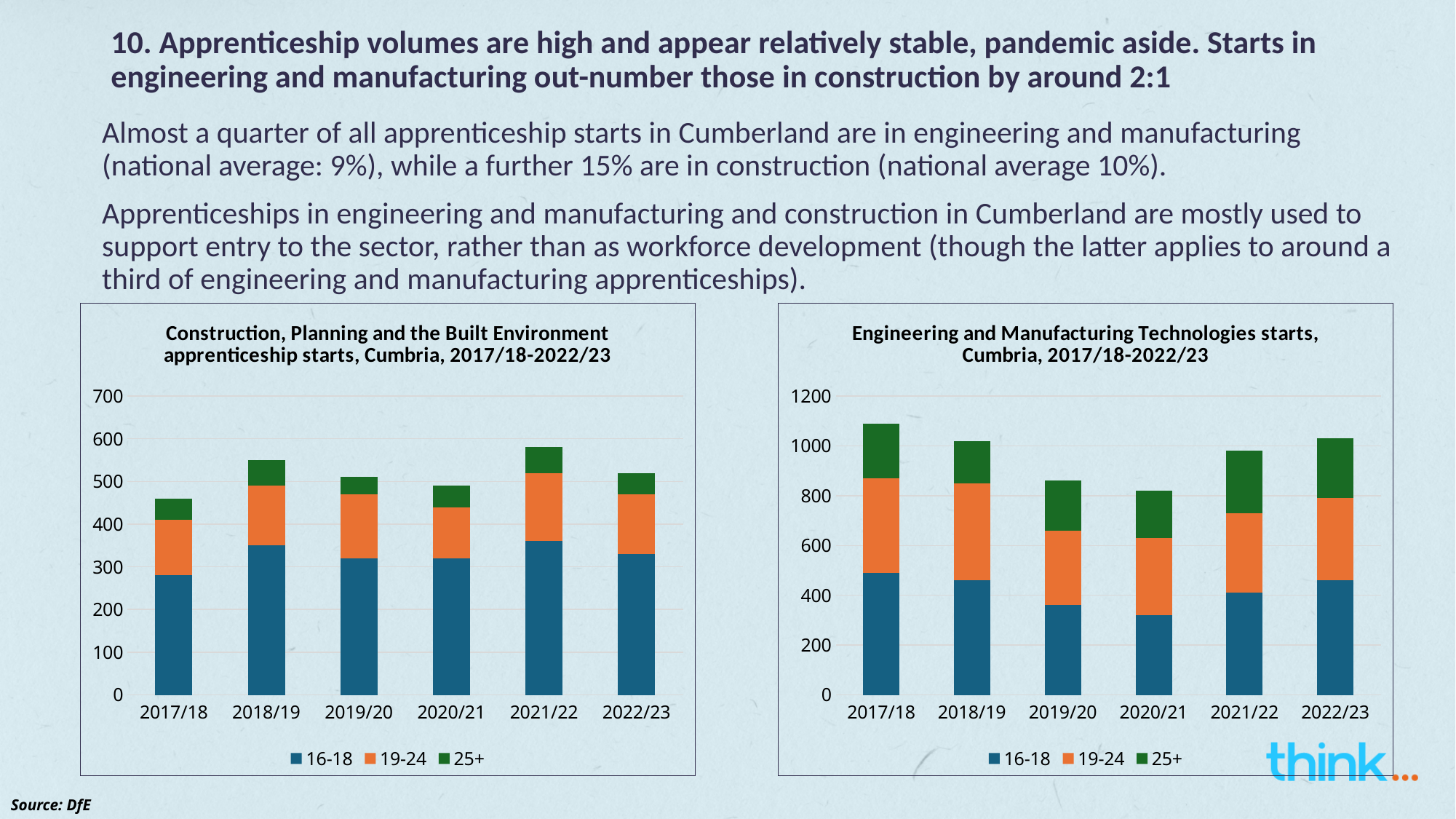
In the Construction, Planning and the Built Environment chart, is the total for 2017/18 greater or less than 500? less In the Engineering and Manufacturing Technologies chart, is the 16-18 segment for 2019/20 greater or less than 400? less In the Construction, Planning and the Built Environment chart, which year has the lowest total number of apprenticeship starts? 2017/18 In the Construction, Planning and the Built Environment chart, which year has the highest total number of apprenticeship starts? 2021/22 How many years are shown on the x axis of the Construction, Planning and the Built Environment chart? 6 How many series does the legend of the Engineering and Manufacturing Technologies chart list? 3 What kind of chart is the Engineering and Manufacturing Technologies chart? Stacked bar chart In the Engineering and Manufacturing Technologies chart, which year has the lowest total number of starts? 2020/21 In the Construction, Planning and the Built Environment chart, is the total for 2021/22 greater or less than 500? greater In the Engineering and Manufacturing Technologies chart, which year has the highest total number of starts? 2017/18